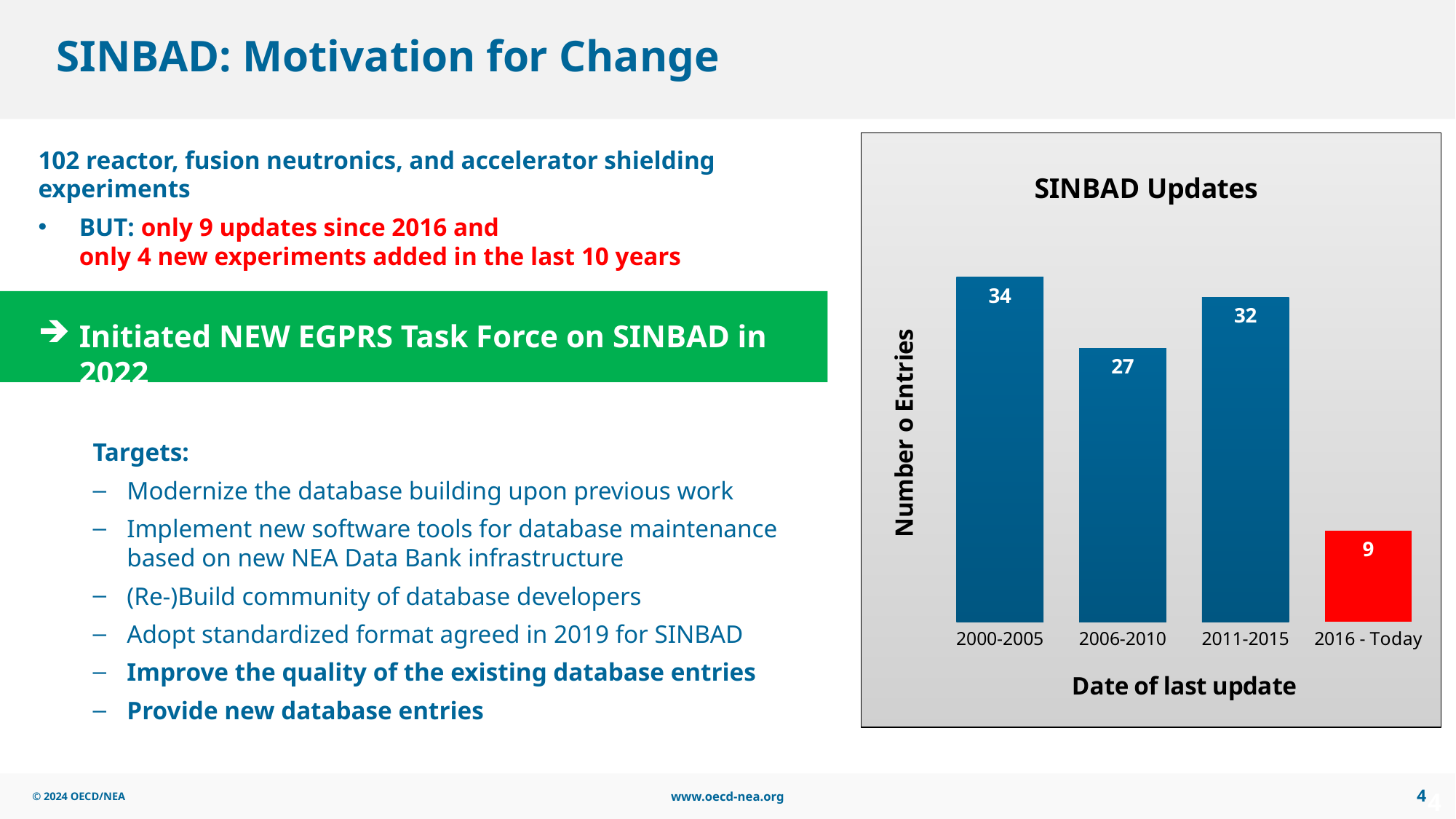
Which period has the lowest number of entries in the SINBAD Updates chart? 2016 - Today What is the difference in number of entries between 2011-2015 and 2006-2010? 5 What is the x-axis label of the SINBAD Updates chart? Date of last update How many periods are shown on the x axis of the SINBAD Updates chart? 4 What is the number of entries for 2000-2005 in the SINBAD Updates chart? 34 What is the difference in number of entries between 2000-2005 and 2016 - Today? 25 What is the number of entries for 2016 - Today in the SINBAD Updates chart? 9 Which period has the highest number of entries in the SINBAD Updates chart? 2000-2005 What kind of chart is the SINBAD Updates chart? bar chart Which period has more entries, 2006-2010 or 2011-2015? 2011-2015 What is the number of entries for 2006-2010 in the SINBAD Updates chart? 27 What is the number of entries for 2011-2015 in the SINBAD Updates chart? 32